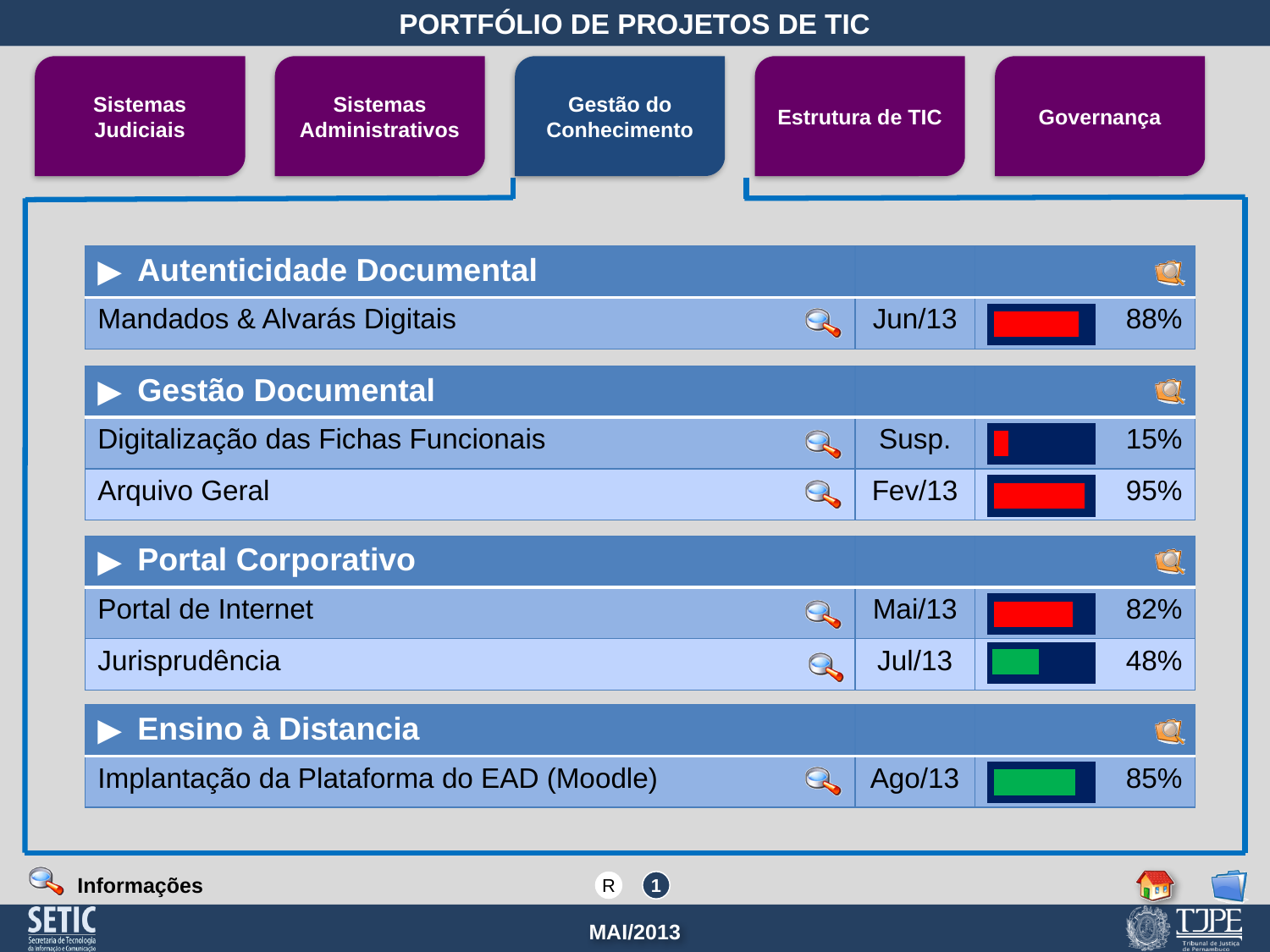
What completion percentage is shown for Mandados & Alvarás Digitais? 88% What completion percentage is shown for Arquivo Geral? 95% Which project has the lowest completion percentage? Digitalização das Fichas Funcionais What completion percentage is shown for Jurisprudência? 48% What date is shown next to Portal de Internet? Mai/13 What is the difference in percentage points between Mandados & Alvarás Digitais and Portal de Internet? 6 What colour is the progress bar for Jurisprudência? Green What completion percentage is shown for Implantação da Plataforma do EAD (Moodle)? 85% How many projects have a progress bar on the slide? 6 What is the difference in percentage points between Arquivo Geral and Digitalização das Fichas Funcionais? 80 Which has a higher completion percentage, Portal de Internet or Jurisprudência? Portal de Internet Which project has the highest completion percentage? Arquivo Geral